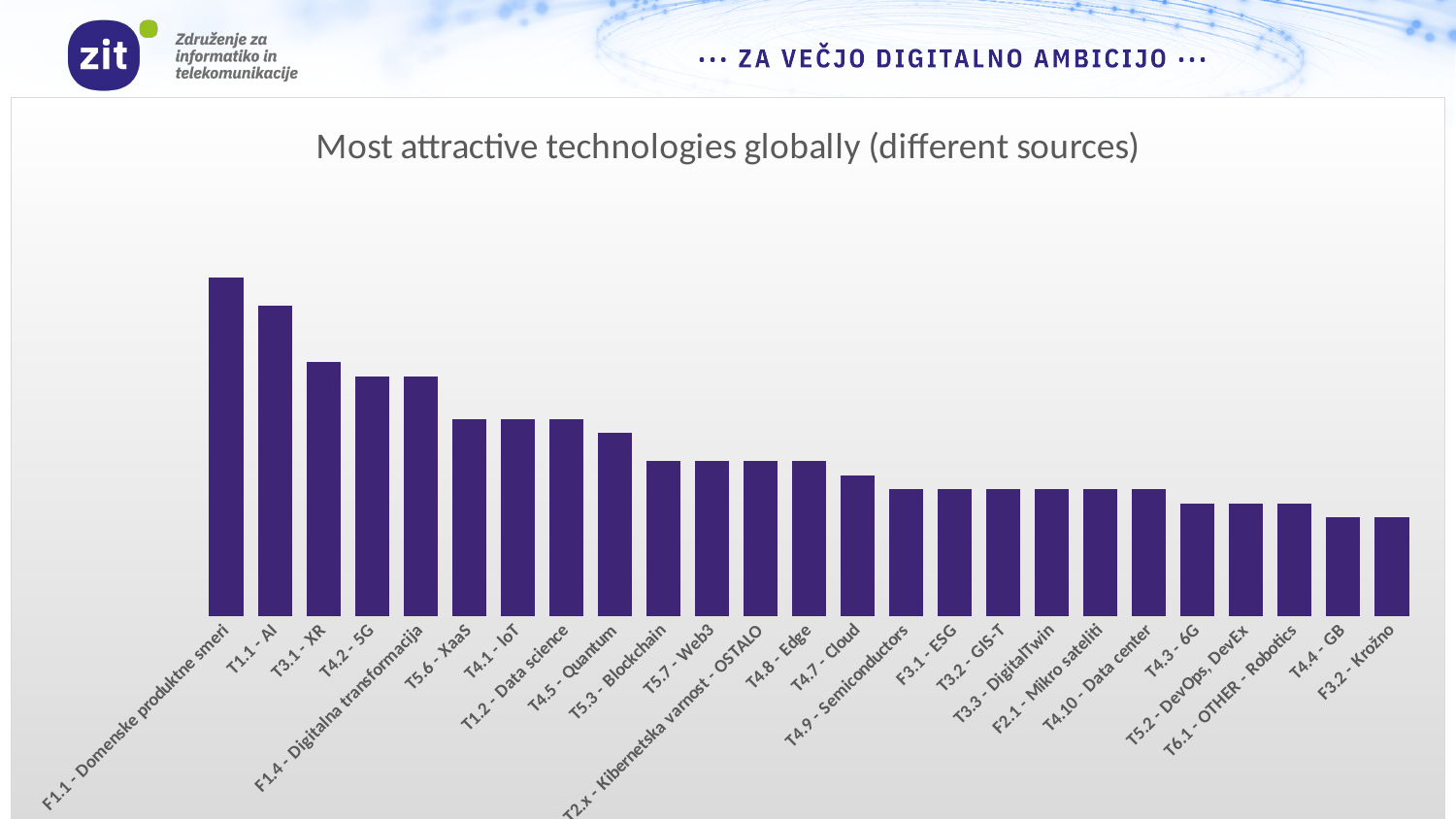
Which is larger, the value for T3.1 - XR or the value for T5.6 - XaaS? T3.1 - XR What colour are the bars in the chart? Dark purple Which is larger, the value for T1.1 - AI or the value for T3.1 - XR? T1.1 - AI Do the bar values rise or fall from left to right along the x axis? Fall What is the title of the chart? Most attractive technologies globally (different sources) Which is larger, the value for T4.7 - Cloud or the value for T4.3 - 6G? T4.7 - Cloud Which category has the second highest bar? T1.1 - AI How many categories (bars) does the chart show? 25 What kind of chart is shown on the slide? Bar chart Which category is the first (leftmost) on the x axis? F1.1 - Domenske produktne smeri Which category has the highest bar? F1.1 - Domenske produktne smeri